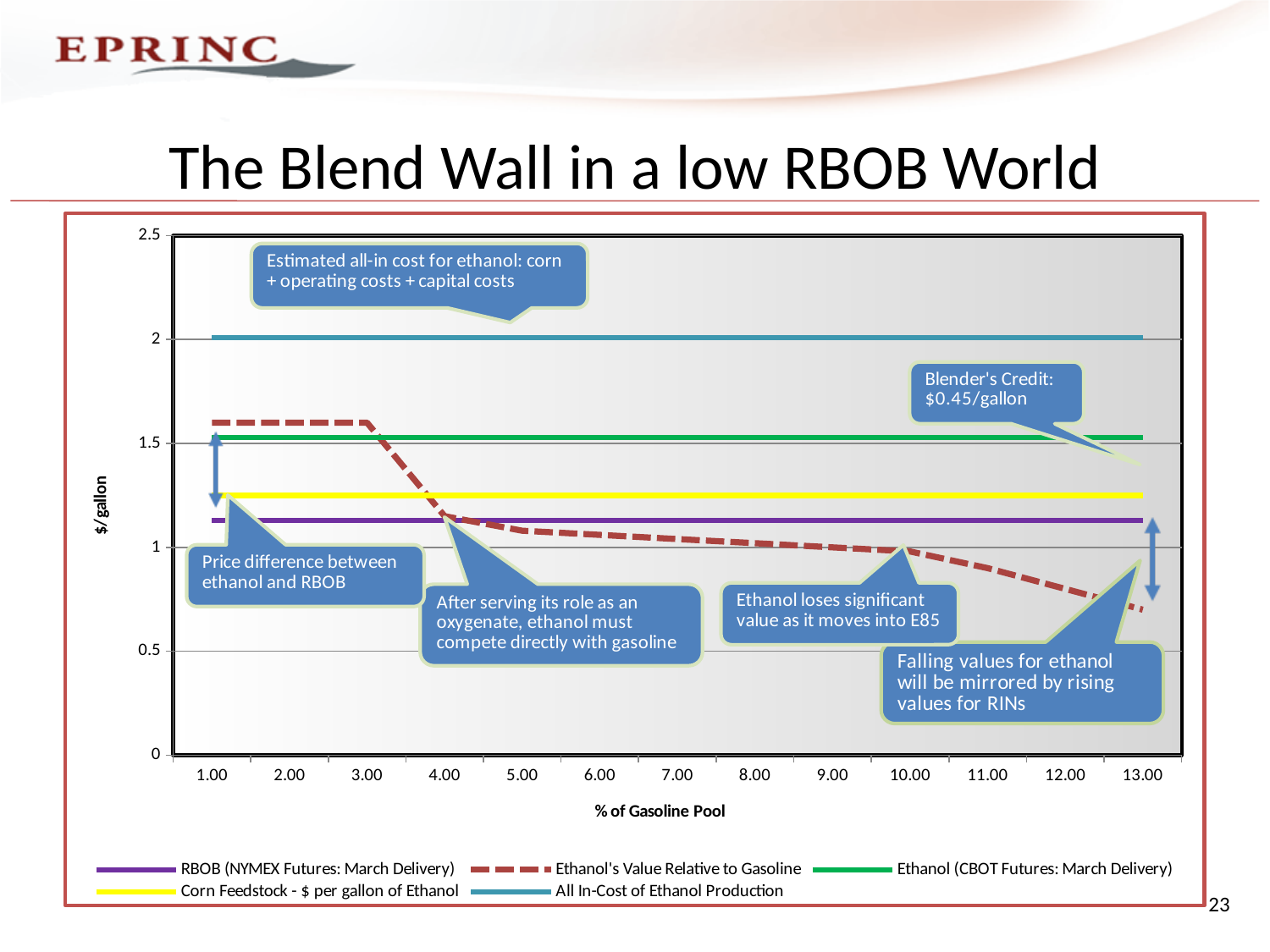
What is the label on the y axis of the chart? $/gallon Does the Ethanol's Value Relative to Gasoline series rise or fall as the % of Gasoline Pool increases? fall Is the value for Corn Feedstock - $ per gallon of Ethanol greater or less than 1? greater Is the value for RBOB (NYMEX Futures: March Delivery) greater or less than 1.5? less Is the value for All In-Cost of Ethanol Production greater or less than 1.5? greater How many points are marked along the x axis (% of Gasoline Pool)? 13 Which series has the lowest value at 13.00 on the x axis? Ethanol's Value Relative to Gasoline Which series has the highest value across the chart? All In-Cost of Ethanol Production How many series does the chart legend list? 5 What kind of chart is shown on the slide? line chart Which is larger, the All In-Cost of Ethanol Production or the Corn Feedstock - $ per gallon of Ethanol? All In-Cost of Ethanol Production